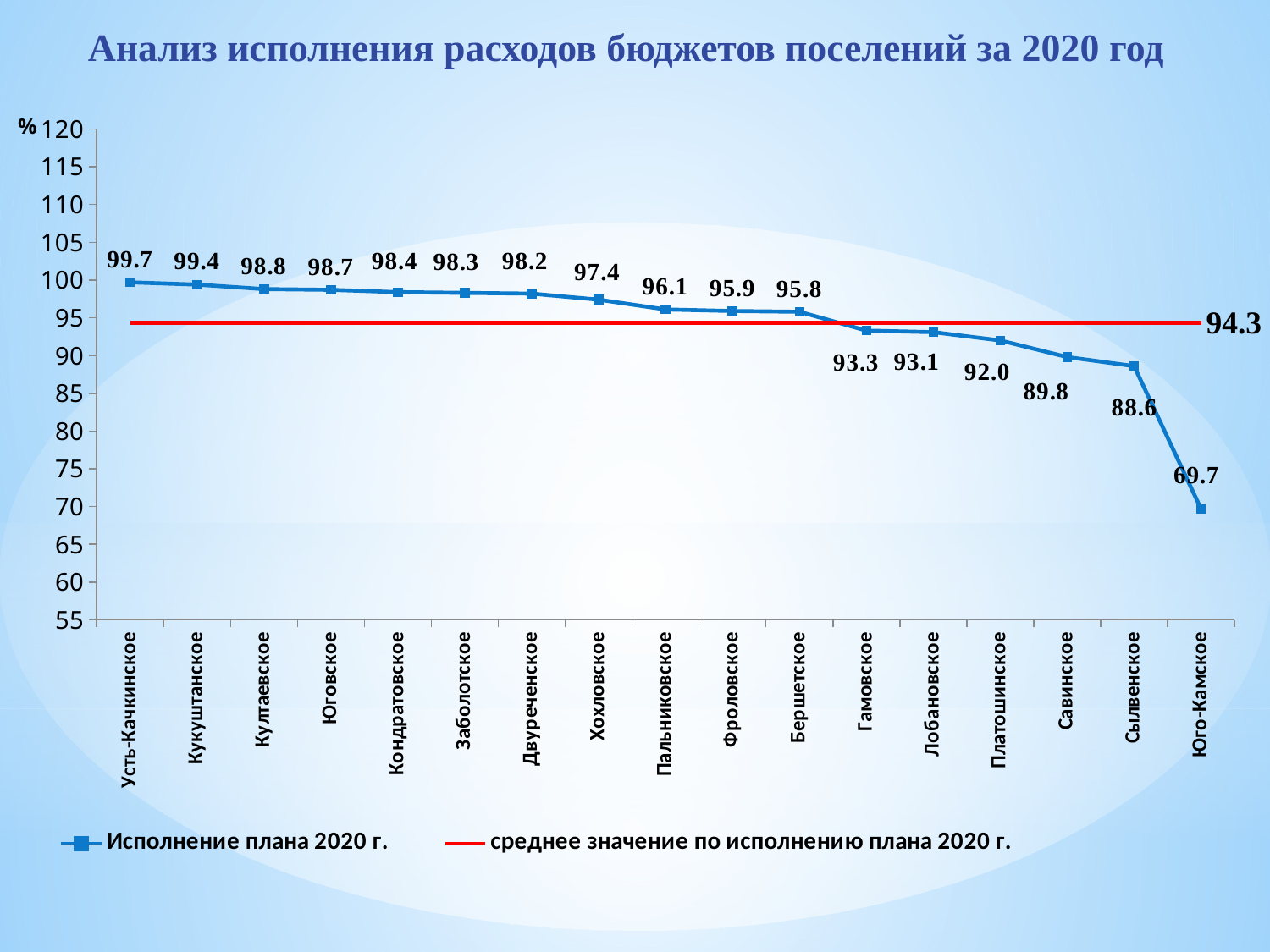
Do the values rise or fall moving from left to right along the x axis? fall What is the plan execution value for Усть-Качкинское? 99.7 What is the plan execution value for Хохловское? 97.4 What type of chart is shown on the slide? line chart What is the average plan execution value shown by the red line? 94.3 Which has a larger value, Гамовское or Платошинское? Гамовское What is the difference between the values for Усть-Качкинское and Юго-Камское? 30.0 Which settlement has the highest plan execution value? Усть-Качкинское Which settlement has the lowest plan execution value? Юго-Камское What is the plan execution value for Сылвенское? 88.6 How many settlements are plotted on the x axis? 17 How many series does the legend list? 2